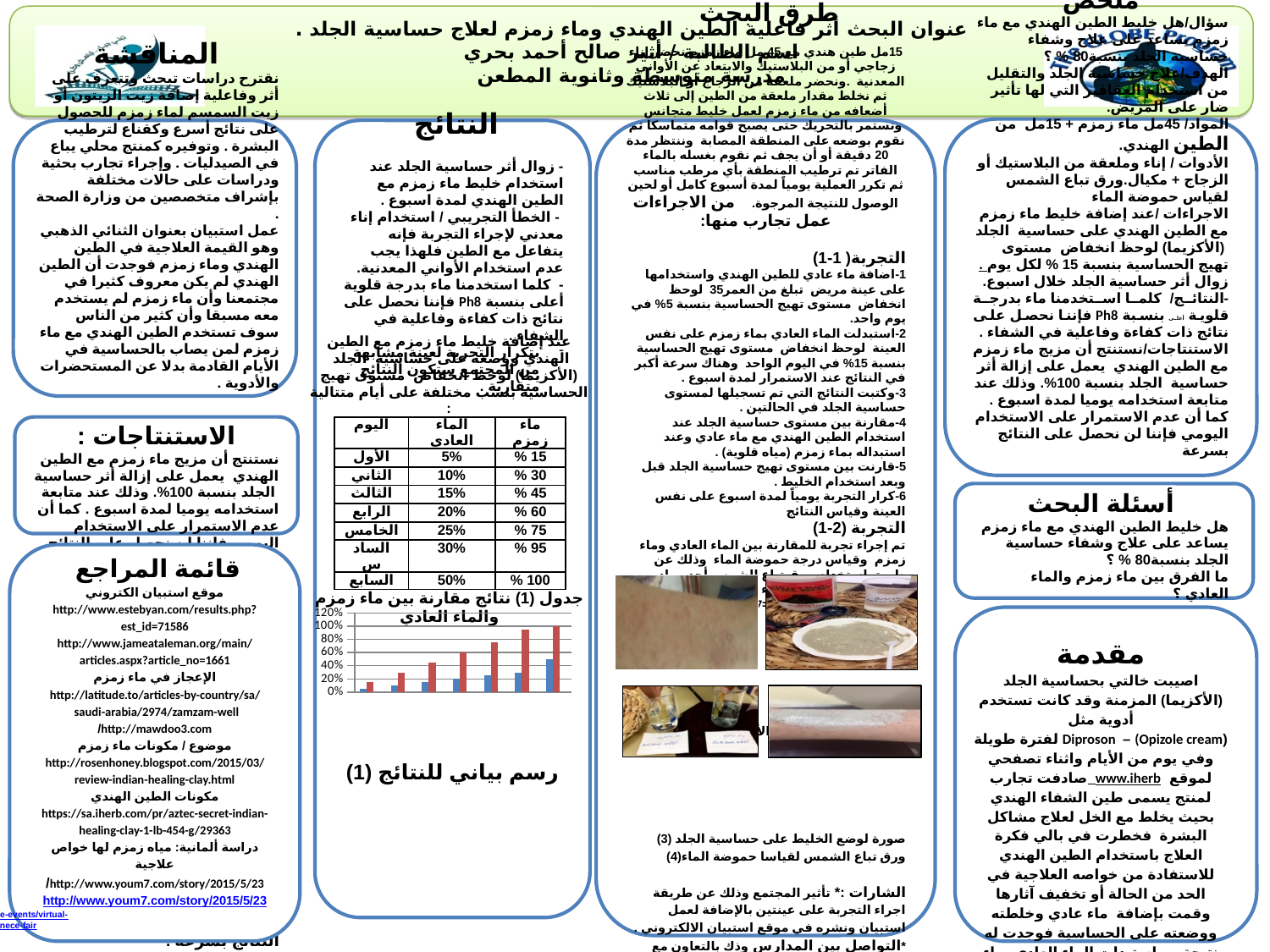
What is the title written under the bar chart at the bottom left of the slide? رسم بياني للنتائج (1) In the chart "رسم بياني للنتائج (1)", which is taller in the rightmost group, the red bar or the blue bar? the red bar In the chart "رسم بياني للنتائج (1)", is the blue bar in the leftmost group greater or less than 20%? less How many different bar colours are plotted in the chart "رسم بياني للنتائج (1)"? 2 In the chart "رسم بياني للنتائج (1)", is the red bar in the fourth group from the left greater or less than 40%? greater In the chart "رسم بياني للنتائج (1)", which group of bars has the tallest red bar? the rightmost (seventh) group In the chart "رسم بياني للنتائج (1)", is the red bar in the rightmost group greater or less than 80%? greater In the chart "رسم بياني للنتائج (1)", which group of bars has the shortest blue bar? the leftmost (first) group What kind of chart is the chart titled "رسم بياني للنتائج (1)" at the bottom left of the slide? bar chart In the chart "رسم بياني للنتائج (1)", do the red bars rise or fall from left to right along the x axis? rise In the chart "رسم بياني للنتائج (1)", how many groups of bars are plotted along the x axis? 7